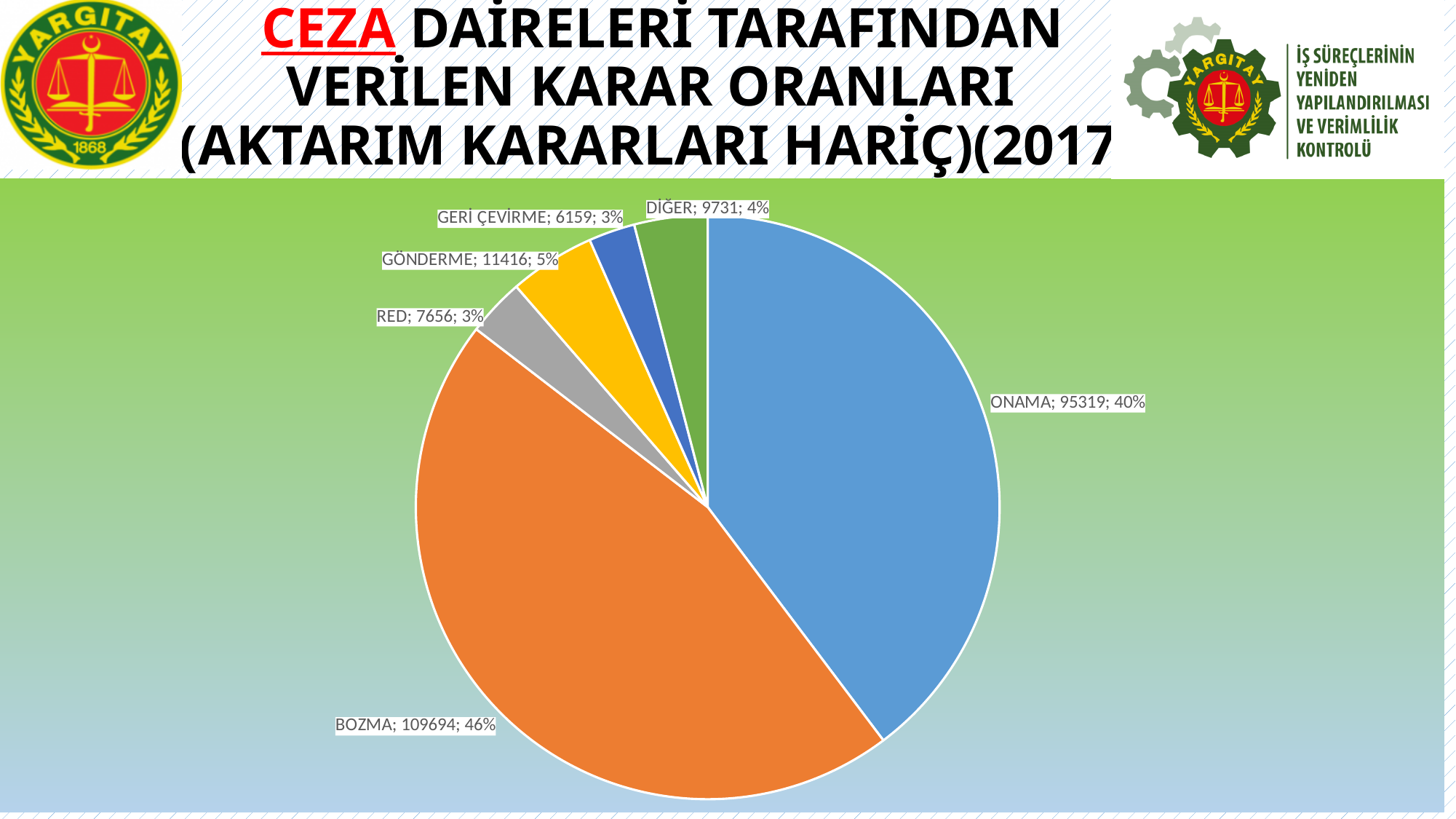
What is the value for BOZMA? 109694 What is the value for ONAMA? 95319 What share of the pie does DİĞER represent? 4% What is the value for GERİ ÇEVİRME? 6159 What is the difference between the values for BOZMA and ONAMA? 14375 Which category has the smallest slice of the pie? GERİ ÇEVİRME Which is larger, the value for RED or the value for DİĞER? DİĞER What share of the pie does ONAMA represent? 40% How many slices does the pie chart have? 6 What type of chart is shown on the slide? pie chart Which category has the largest slice of the pie? BOZMA What is the value for GÖNDERME? 11416